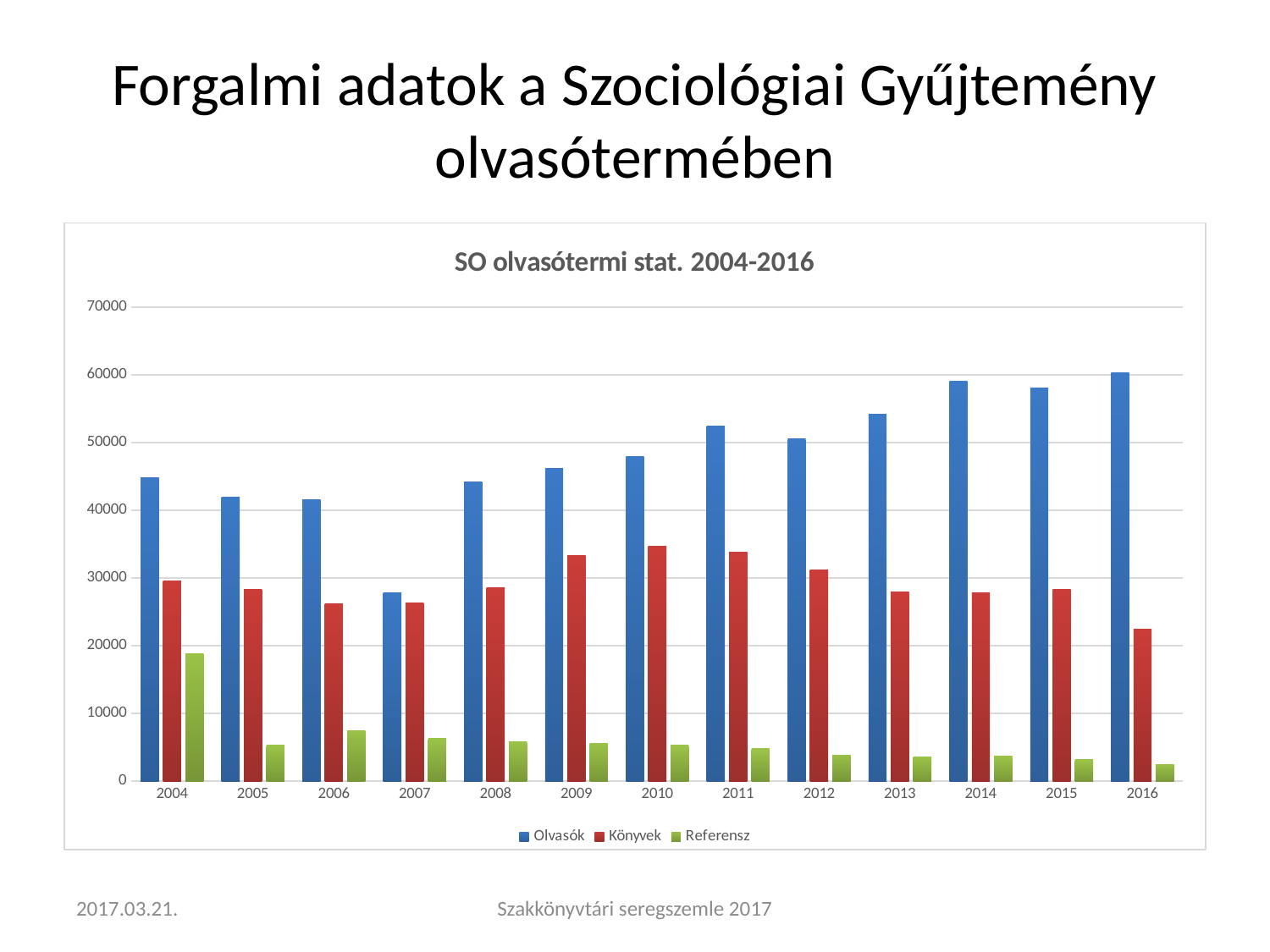
What type of chart is shown on the slide? bar chart In which year is the Olvasók value the lowest? 2007 What is the title of the chart? SO olvasótermi stat. 2004-2016 In which year is the Olvasók value the highest? 2016 Does the Referensz series generally rise or fall from 2004 to 2016? fall In which year is the Könyvek value the lowest? 2016 Is the Referensz value for 2004 greater or less than 10000? greater Which is larger in 2010, the Olvasók value or the Könyvek value? Olvasók In which year is the Referensz value the highest? 2004 Is the Olvasók value for 2014 greater or less than 50000? greater How many years are shown on the x axis? 13 How many series does the legend list? 3